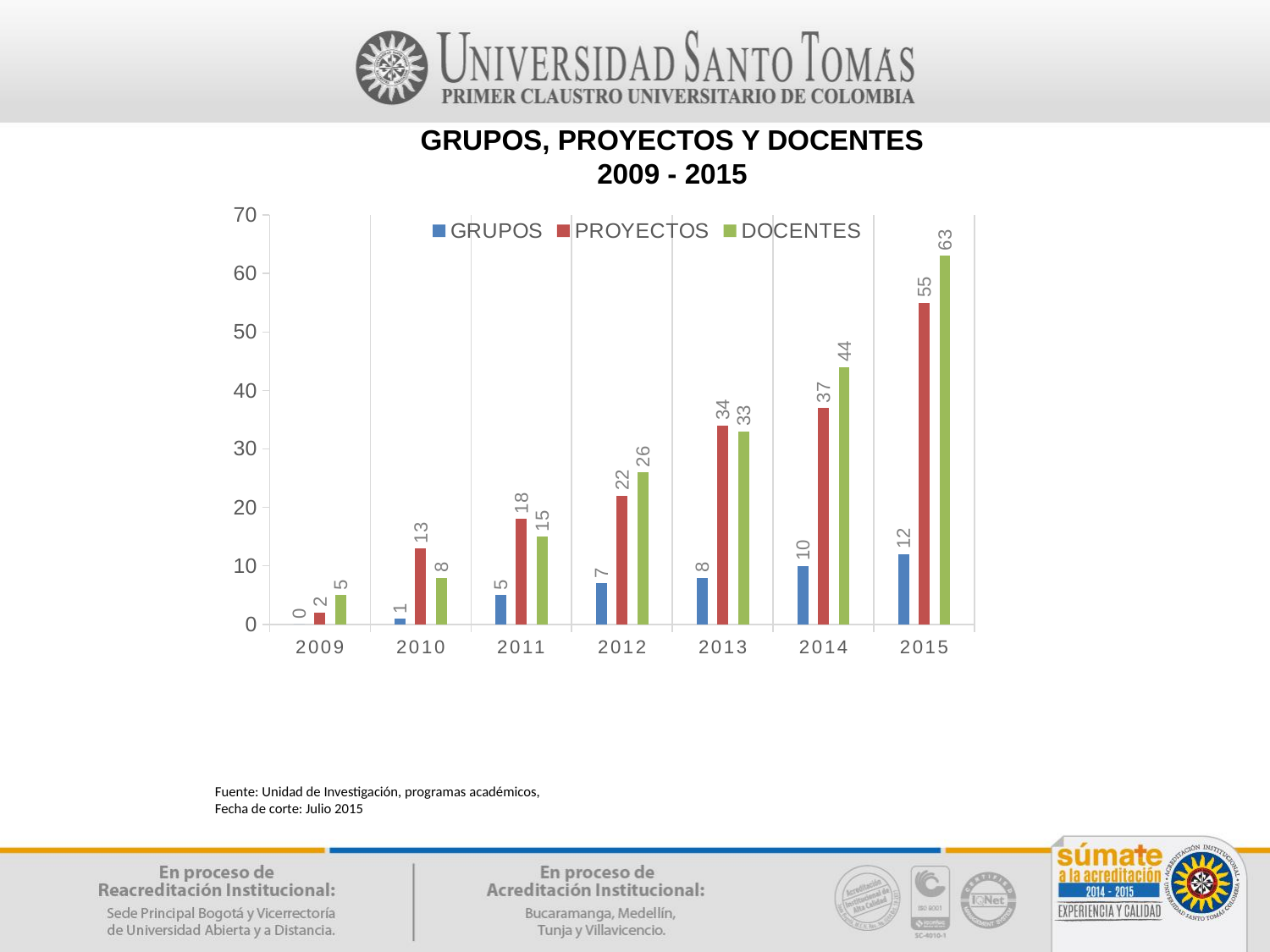
What is the value for GRUPOS in 2014? 10 What is the value for PROYECTOS in 2012? 22 What kind of chart is shown on the slide? Bar chart Which year has the highest value for PROYECTOS? 2015 How many series does the legend list? 3 Which is larger in 2013, PROYECTOS or DOCENTES? PROYECTOS What is the value for DOCENTES in 2015? 63 Which year has the lowest value for GRUPOS? 2009 Do the DOCENTES values rise or fall from 2009 to 2015? Rise What is the difference between DOCENTES and PROYECTOS in 2015? 8 What is the title of the chart? GRUPOS, PROYECTOS Y DOCENTES 2009 - 2015 How many years are shown on the x axis? 7